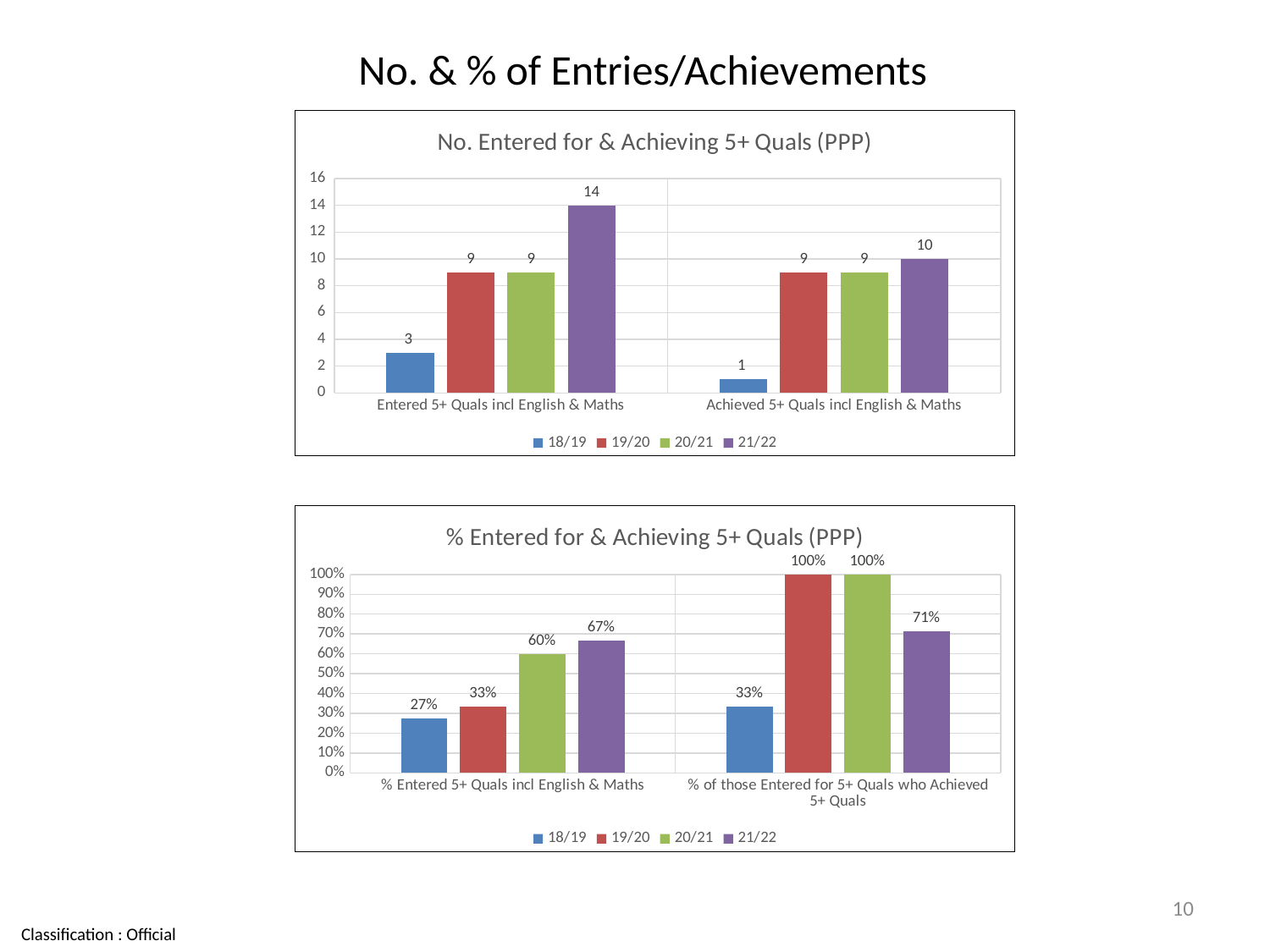
In the 'No. Entered for & Achieving 5+ Quals (PPP)' chart, which series has the highest value in the 'Entered 5+ Quals incl English & Maths' category? 21/22 In the 'No. Entered for & Achieving 5+ Quals (PPP)' chart, what is the value for 18/19 in the 'Achieved 5+ Quals incl English & Maths' category? 1 In the '% Entered for & Achieving 5+ Quals (PPP)' chart, which series has the lowest value in the '% Entered 5+ Quals incl English & Maths' category? 18/19 In the 'No. Entered for & Achieving 5+ Quals (PPP)' chart, what is the value for 21/22 in the 'Entered 5+ Quals incl English & Maths' category? 14 In the '% Entered for & Achieving 5+ Quals (PPP)' chart, is the 19/20 value for '% of those Entered for 5+ Quals who Achieved 5+ Quals' larger or smaller than the 21/22 value in the same category? larger In the 'No. Entered for & Achieving 5+ Quals (PPP)' chart, what is the difference between the 21/22 values for 'Entered 5+ Quals incl English & Maths' and 'Achieved 5+ Quals incl English & Maths'? 4 What kind of chart is the '% Entered for & Achieving 5+ Quals (PPP)' chart? bar chart In the '% Entered for & Achieving 5+ Quals (PPP)' chart, what is the value for 21/22 in the '% of those Entered for 5+ Quals who Achieved 5+ Quals' category? 71% In the '% Entered for & Achieving 5+ Quals (PPP)' chart, what is the difference between the 21/22 and 18/19 values in the '% Entered 5+ Quals incl English & Maths' category? 40% In the 'No. Entered for & Achieving 5+ Quals (PPP)' chart, which series has the lowest value in the 'Achieved 5+ Quals incl English & Maths' category? 18/19 In the '% Entered for & Achieving 5+ Quals (PPP)' chart, what is the value for 20/21 in the '% Entered 5+ Quals incl English & Maths' category? 60% In the 'No. Entered for & Achieving 5+ Quals (PPP)' chart, how many series does the legend list? 4